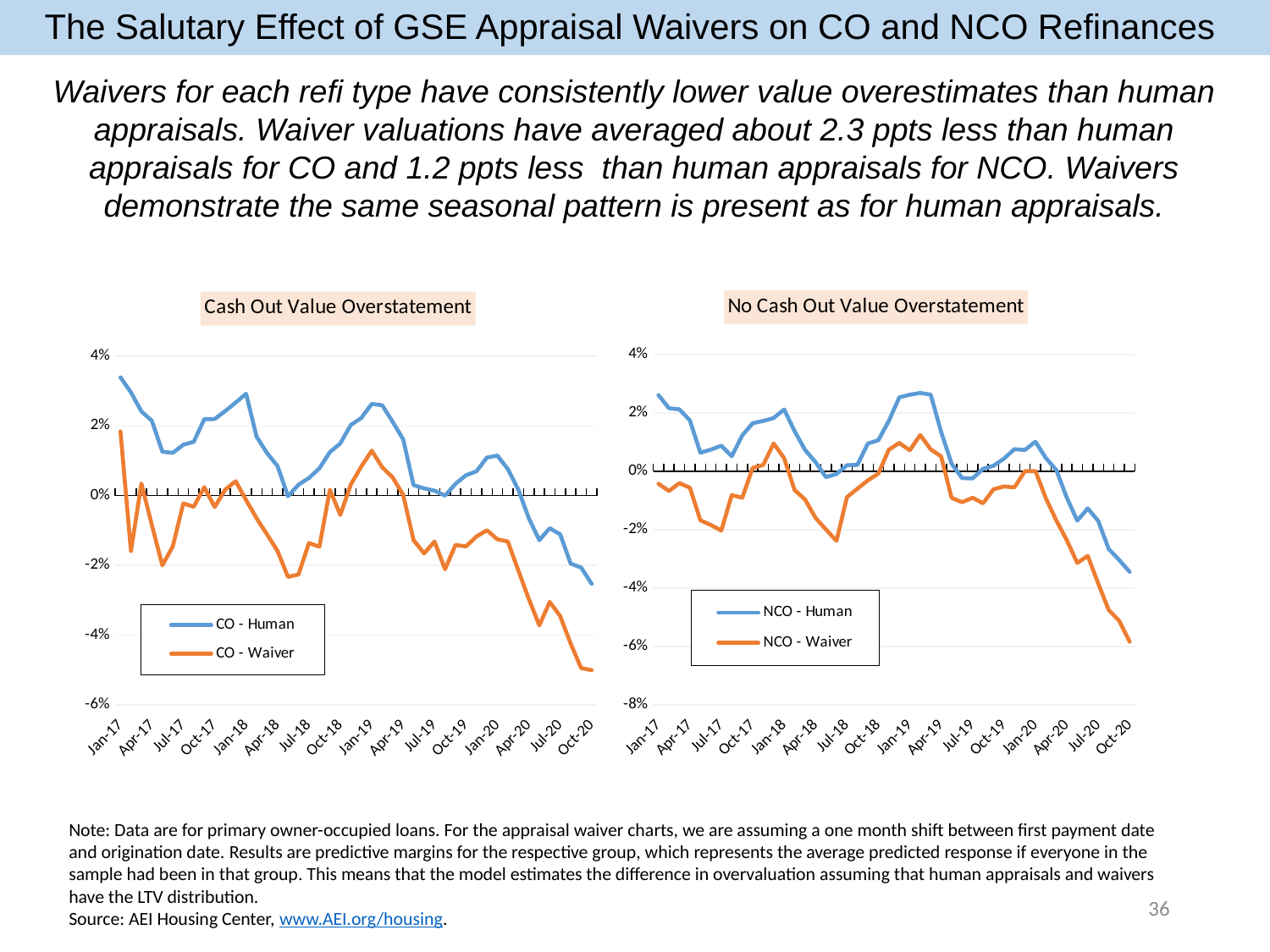
In the "No Cash Out Value Overstatement" chart, which series has the higher value at Oct-20, NCO - Human or NCO - Waiver? NCO - Human In the "No Cash Out Value Overstatement" chart, is the value for NCO - Waiver at Oct-20 greater or less than -4%? less What kind of chart is the "Cash Out Value Overstatement" chart? line chart In the "No Cash Out Value Overstatement" chart, which colour is the NCO - Waiver line? orange In the "Cash Out Value Overstatement" chart, is the value for CO - Human at Oct-20 greater or less than -2%? less In the "No Cash Out Value Overstatement" chart, does the NCO - Waiver line overall rise or fall from Jan-17 to Oct-20? fall In the "Cash Out Value Overstatement" chart, what are the two series named in the legend? CO - Human and CO - Waiver In the "No Cash Out Value Overstatement" chart, is the value for NCO - Human at Jan-17 greater or less than 2%? greater In the "Cash Out Value Overstatement" chart, which series has the higher value at Jan-17, CO - Human or CO - Waiver? CO - Human How many series does the legend of the "No Cash Out Value Overstatement" chart list? 2